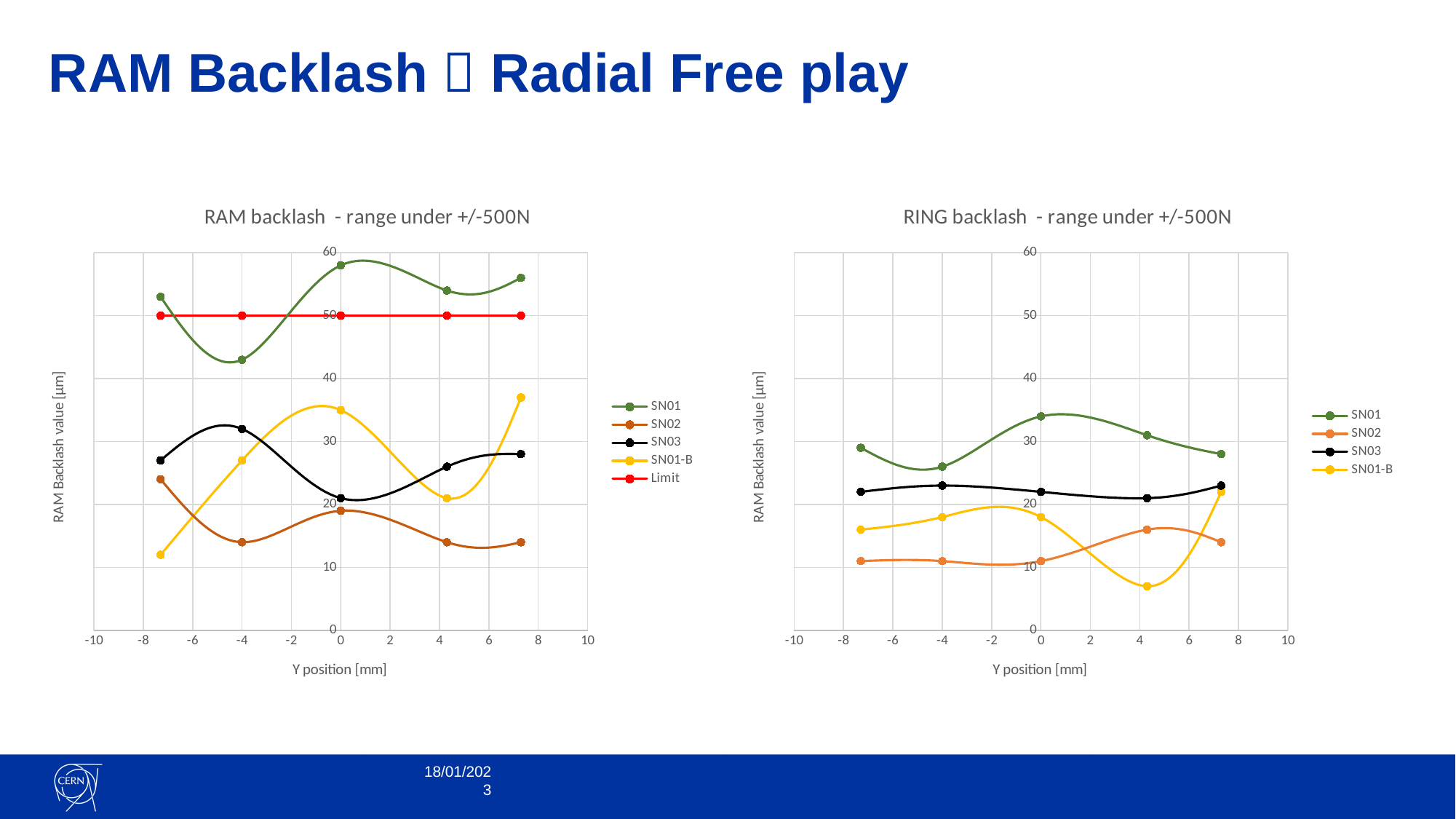
In the RAM backlash chart, which series has the highest value at Y position 0? SN01 In the RAM backlash chart, is the SN01 value at Y position 0 greater or less than 50? greater In the RING backlash chart, which series has the lowest value at Y position 4? SN01-B What kind of chart is the RAM backlash chart on the left? line chart In the RAM backlash chart, which is larger at Y position -8 (leftmost point): SN01 or SN01-B? SN01 How many data points does each series have in the RING backlash chart? 5 How many series does the legend of the RING backlash chart list? 4 In the RAM backlash chart, is the SN02 value at Y position -4 greater or less than 20? less How many series does the legend of the RAM backlash chart list? 5 In the RING backlash chart, is the SN01-B value at Y position 4 greater or less than 10? less In the RAM backlash chart, what constant value does the Limit series hold? 50